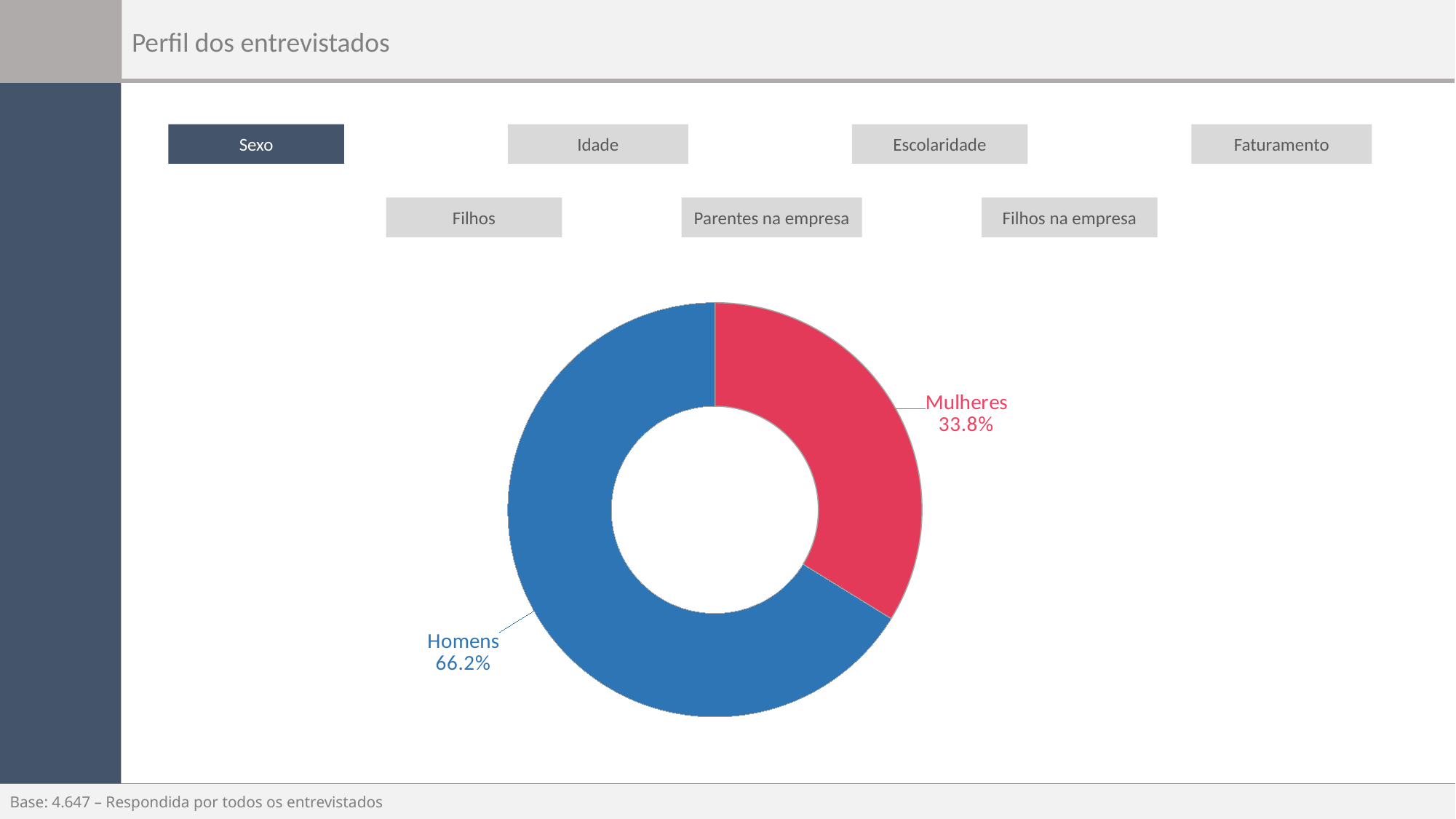
Which is larger, the share for Homens or the share for Mulheres? Homens What percentage of respondents are Homens? 66.2% What is the total of the two slices shown in the chart? 100% What percentage of respondents are Mulheres? 33.8% Which category has the smallest share of the chart? Mulheres Which profile tab is highlighted above the chart? Sexo How many categories are shown in the chart? 2 Which category has the largest share of the chart? Homens What colour is the Mulheres slice? Red What kind of chart is shown on the slide? Doughnut chart What is the difference in percentage points between Homens and Mulheres? 32.4